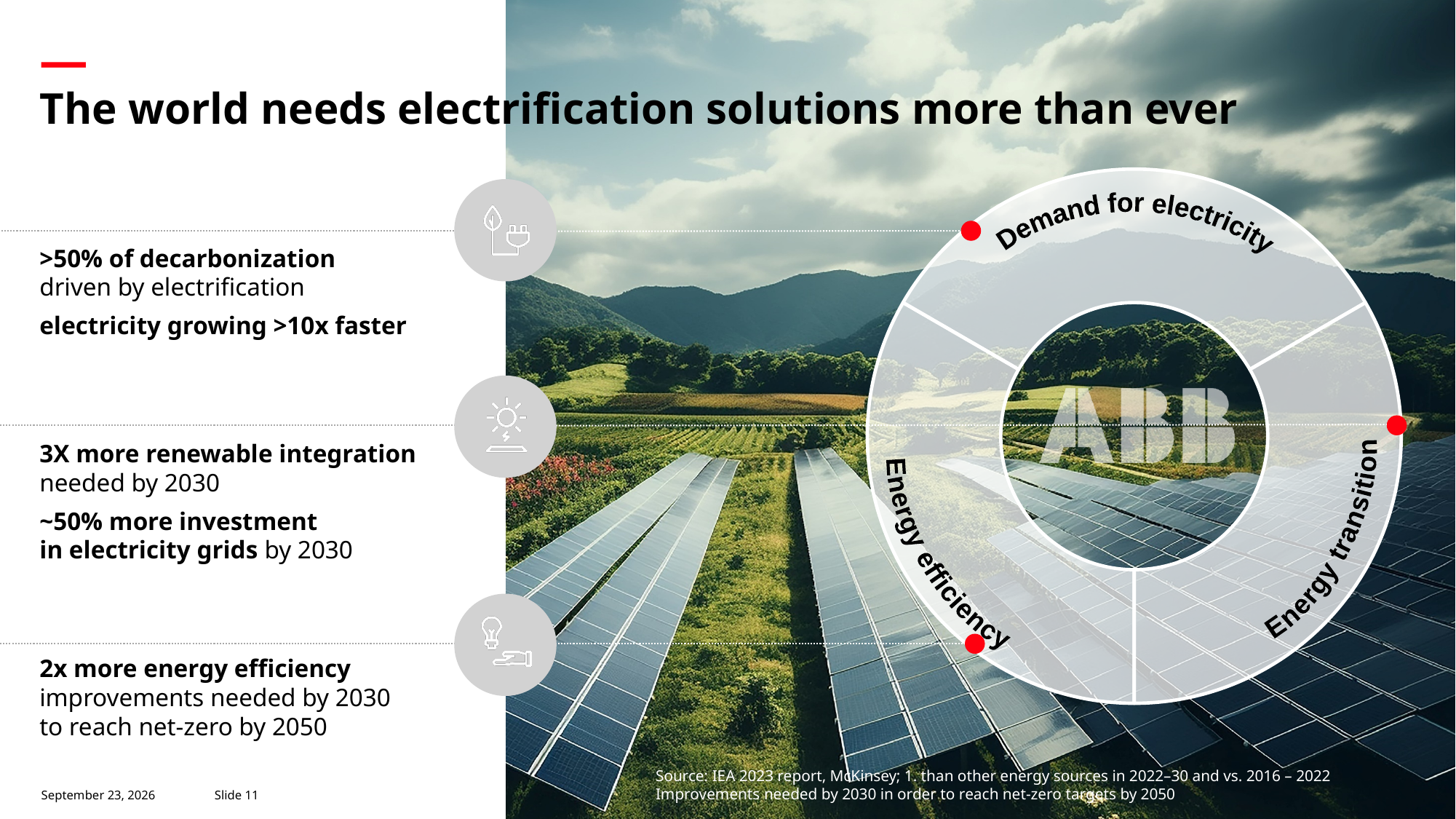
How many segments does the ring diagram on the right of the slide have? 3 What logo appears in the centre of the ring diagram? ABB What is the label of the lower-left segment of the ring diagram? Energy efficiency What is the label of the right-hand segment of the ring diagram? Energy transition What shape is the diagram on the right of the slide: a ring (doughnut) or a bar chart? ring (doughnut) What is the label of the top segment of the ring diagram? Demand for electricity